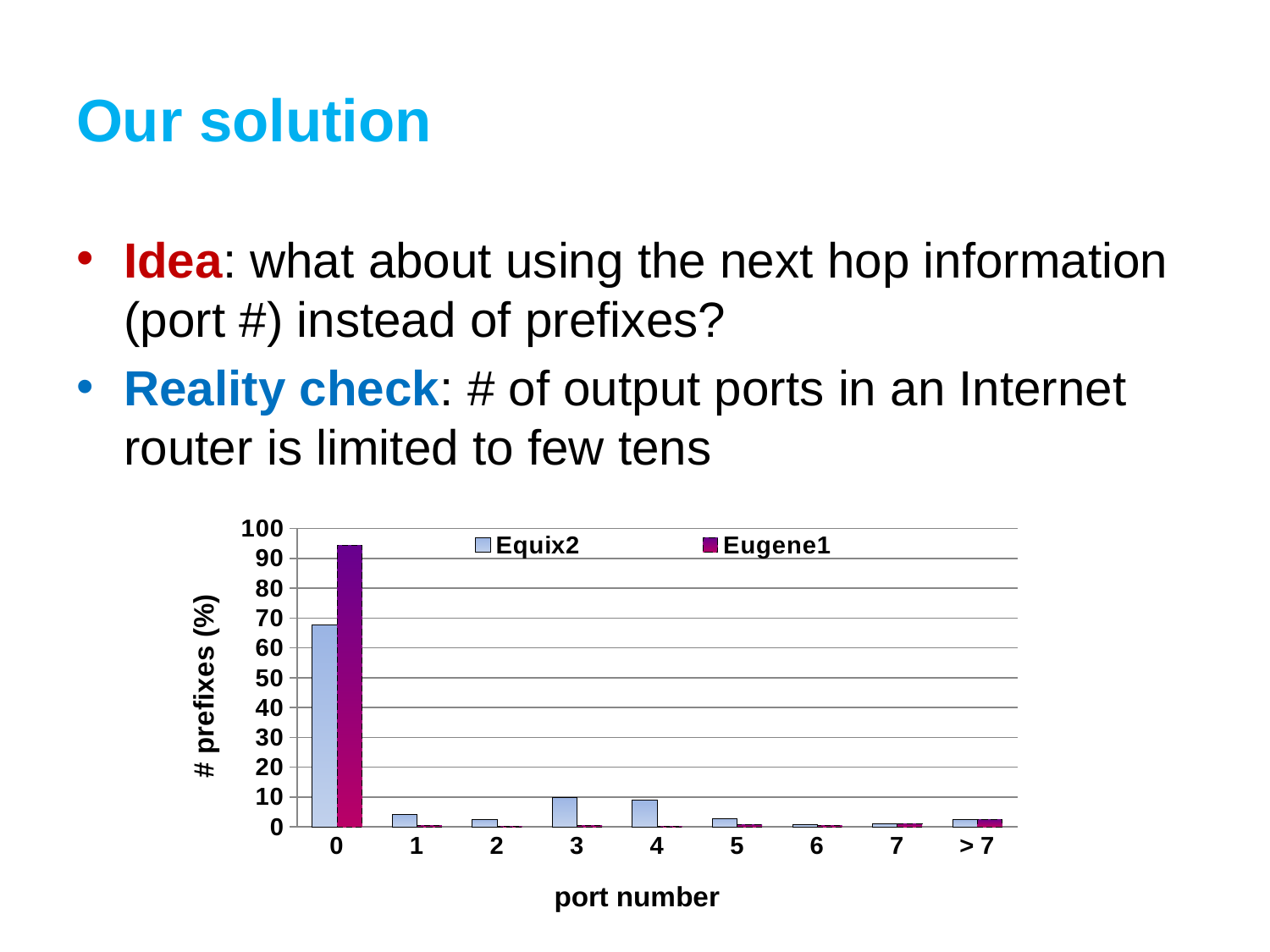
Is the value for Equix2 at port number 4 greater or less than 20? less What kind of chart is shown on the slide? bar chart Which port number has the highest value for Eugene1? 0 What is the label of the y axis? # prefixes (%) Is the value for Equix2 at port number 0 greater or less than 60? greater How many series does the legend list? 2 At port number 0, which series has the larger value, Equix2 or Eugene1? Eugene1 Is the value for Eugene1 at port number 0 greater or less than 90? greater Which port number has the highest value for Equix2? 0 What is the label of the x axis? port number How many port number categories are shown on the x axis? 9